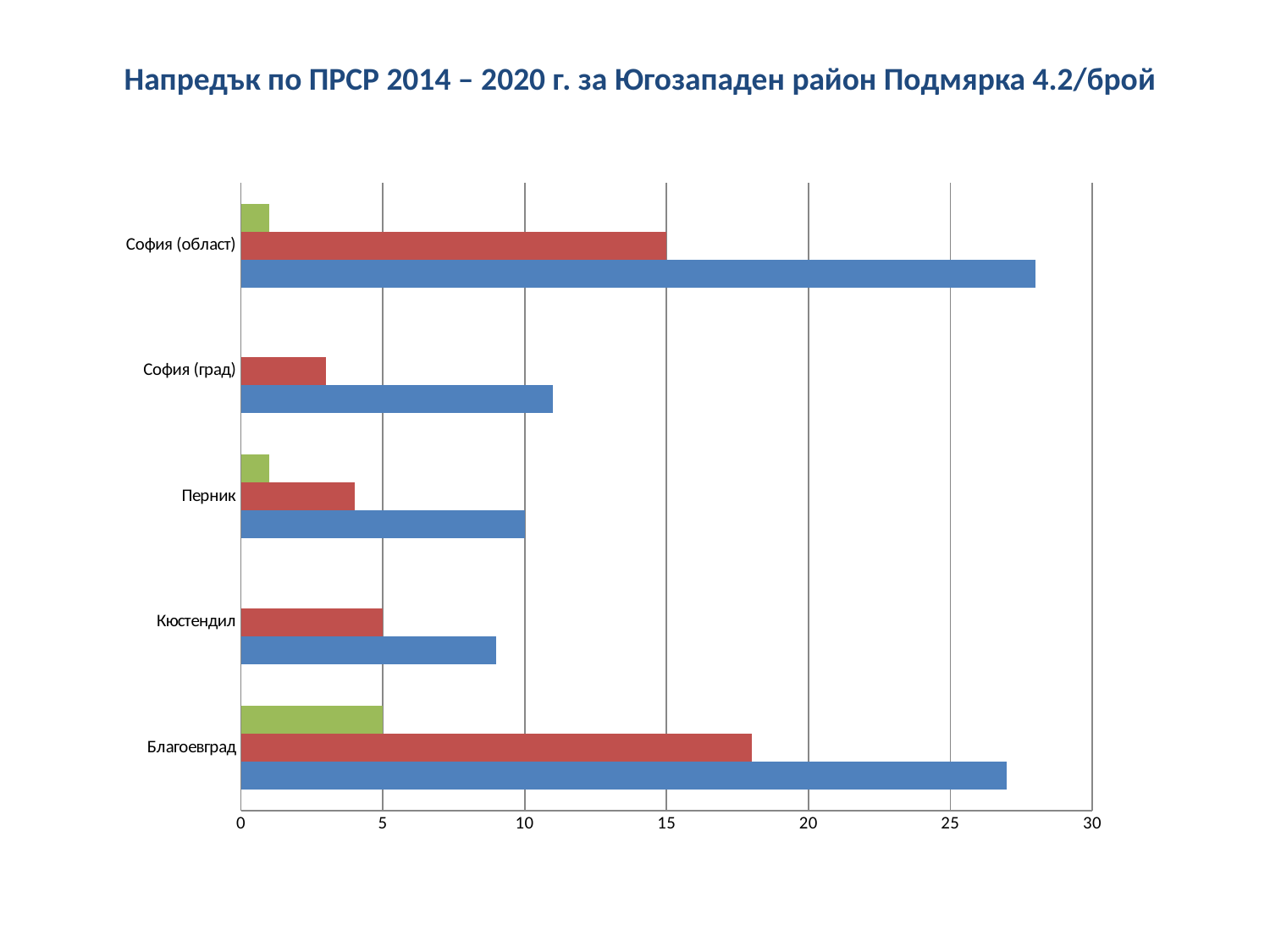
Is the value of the red bar for Благоевград greater or less than 15? greater What is the value of the green bar for Благоевград? 5 Is the value of the blue bar for София (област) greater or less than 25? greater What is the value of the blue bar for Перник? 10 What is the value of the red bar for София (област)? 15 Is the value of the blue bar for Кюстендил greater or less than 10? less How many categories are shown on the vertical axis of the chart? 5 What is the title of the chart? Напредък по ПРСР 2014 – 2020 г. за Югозападен район Подмярка 4.2/брой Which is larger: the blue bar for София (град) or the blue bar for Благоевград? Благоевград What is the value of the red bar for Кюстендил? 5 Which category has the highest value for the red bar? Благоевград What kind of chart is shown on the slide? bar chart